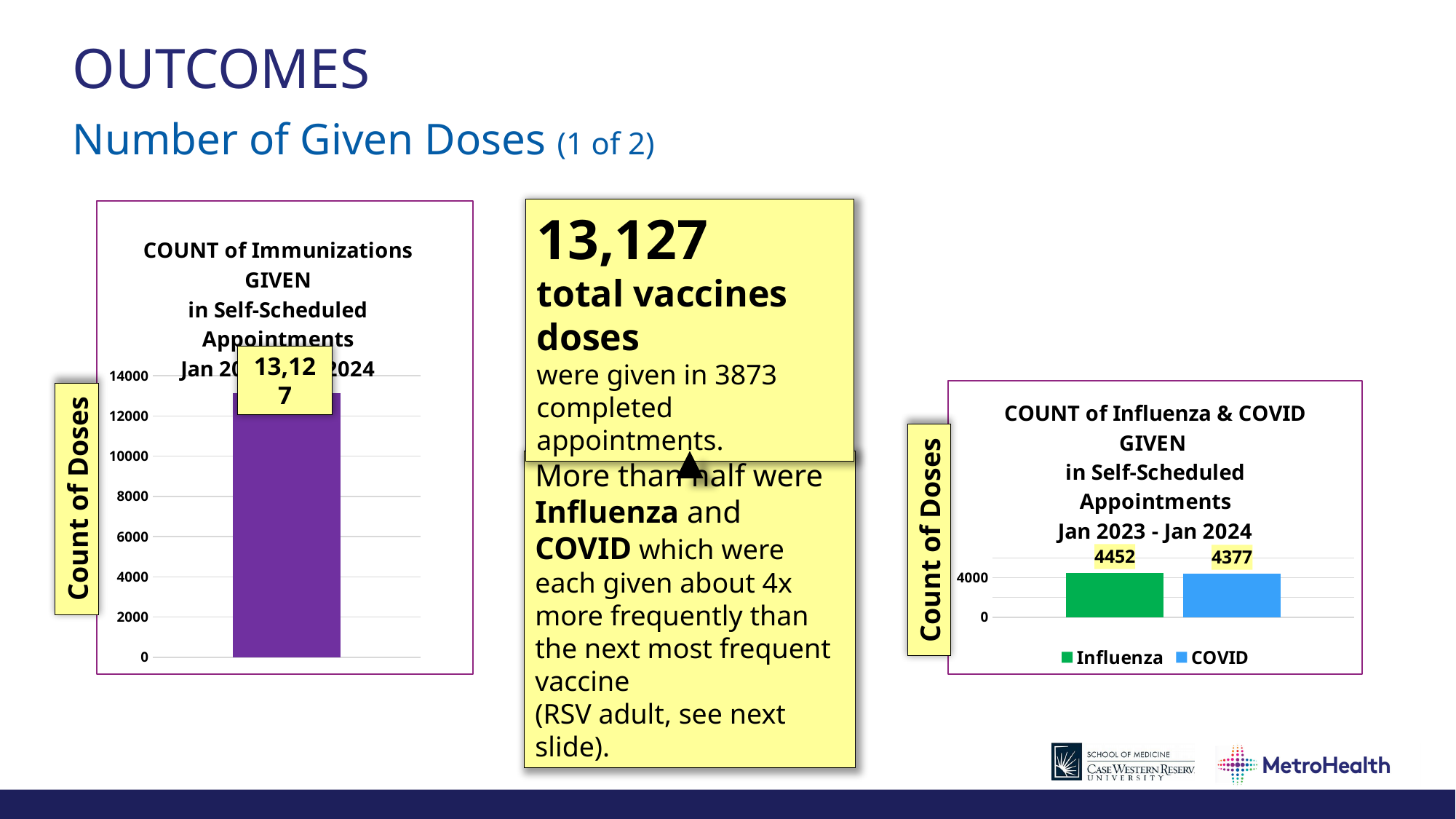
In the right chart (COUNT of Influenza & COVID GIVEN), which series has the higher value, Influenza or COVID? Influenza In the right chart (COUNT of Influenza & COVID GIVEN), what is the value for COVID? 4377 In the right chart (COUNT of Influenza & COVID GIVEN), what colour is the Influenza bar? Green What is the y-axis label shown beside the left chart (COUNT of Immunizations GIVEN)? Count of Doses In the left chart (COUNT of Immunizations GIVEN), what value is shown on the data label of the bar? 13,127 In the right chart (COUNT of Influenza & COVID GIVEN), what is the value for Influenza? 4452 In the left chart (COUNT of Immunizations GIVEN), is the bar's value greater or less than 14000? less What type of chart is the left chart (COUNT of Immunizations GIVEN)? Bar chart In the right chart (COUNT of Influenza & COVID GIVEN), how many series does the legend list? 2 In the left chart (COUNT of Immunizations GIVEN), how many bars are plotted? 1 In the right chart (COUNT of Influenza & COVID GIVEN), what is the difference between the Influenza and COVID values? 75 In the left chart (COUNT of Immunizations GIVEN), is the bar's value greater or less than 12000? greater